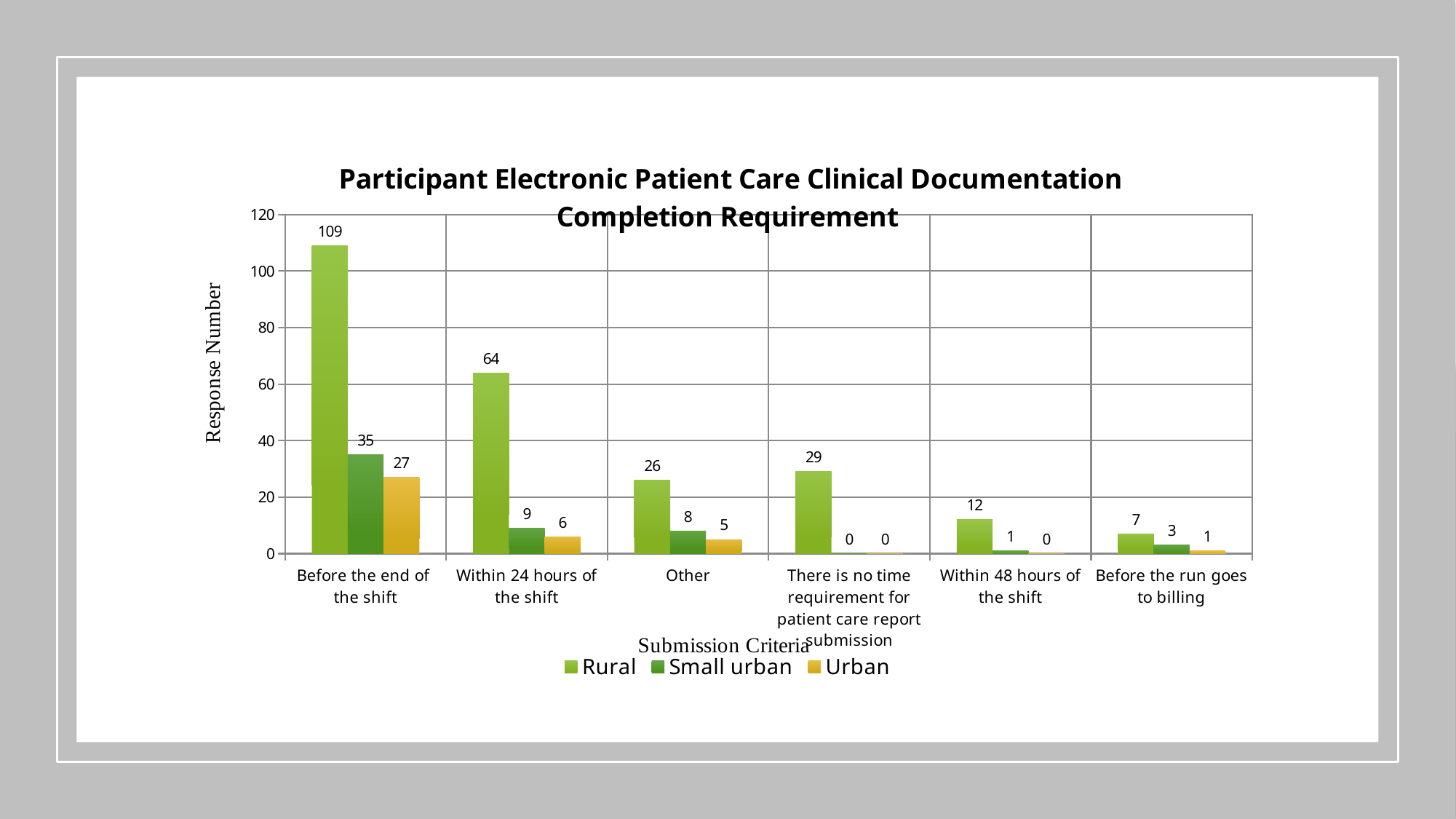
Is the Rural value for "Within 24 hours of the shift" greater or less than 60? greater What is the difference between the Rural and Small urban values for "Before the end of the shift"? 74 What is the label of the y axis? Response Number Which is larger: the Rural value for "Other" or the Rural value for "There is no time requirement for patient care report submission"? There is no time requirement for patient care report submission What is the Small urban value for "Other"? 8 Which category has the lowest Rural value? Before the run goes to billing What is the Urban value for "Within 24 hours of the shift"? 6 Which category has the highest Rural value? Before the end of the shift What kind of chart is shown? Bar chart How many categories are shown on the x axis? 6 What is the Rural value for "Before the end of the shift"? 109 How many series does the legend list? 3